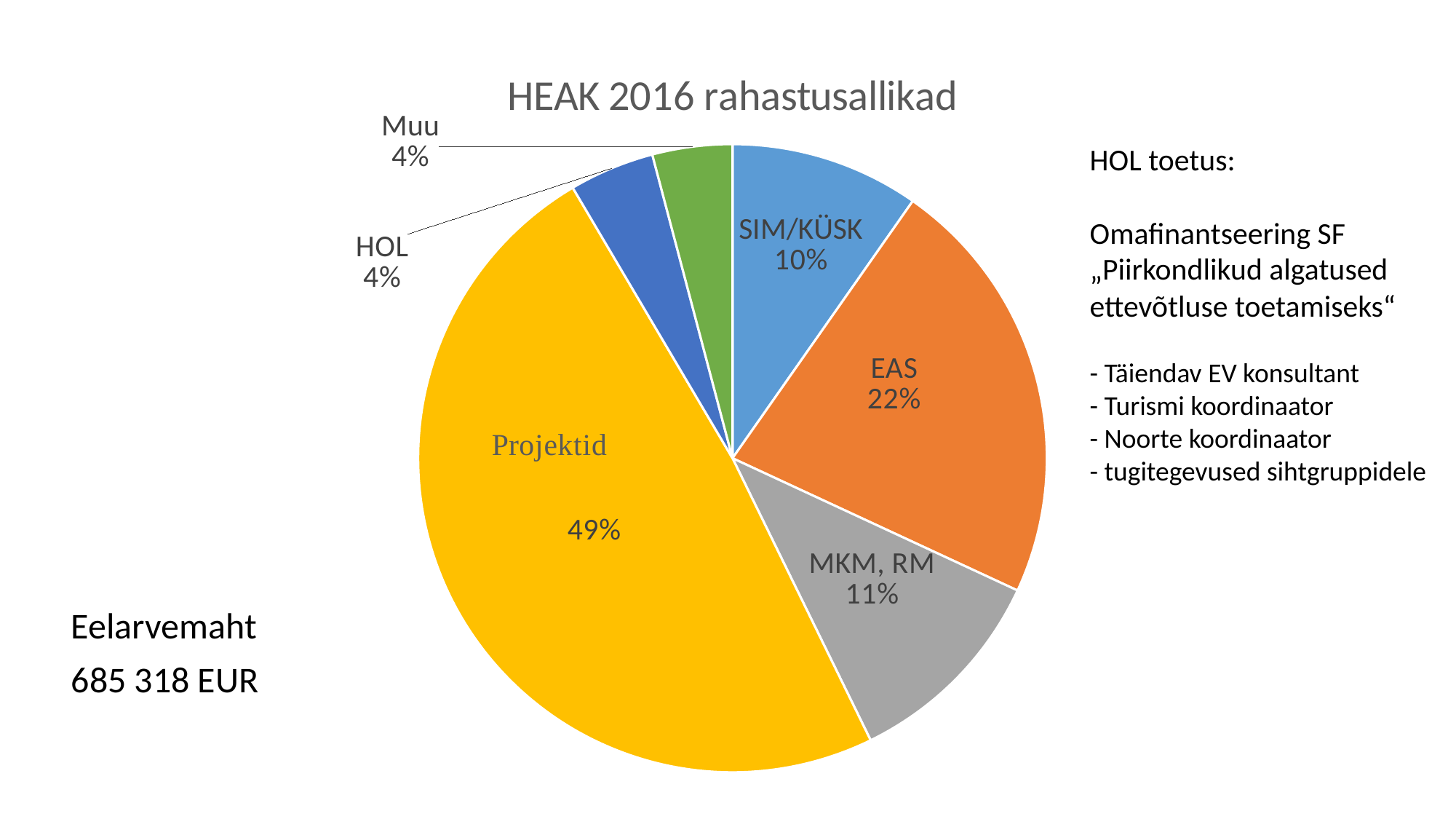
What kind of chart is shown on the slide? pie chart What is the difference between the shares of Projektid and EAS? 27% How many slices does the pie chart have? 6 What is the title of the chart? HEAK 2016 rahastusallikad Which is larger, the share of EAS or the share of MKM, RM? EAS What share of the pie does EAS have? 22% What colour is the Projektid slice? yellow What share of the pie does Projektid have? 49% What share of the pie does SIM/KÜSK have? 10% Which slice is the largest in the pie chart? Projektid